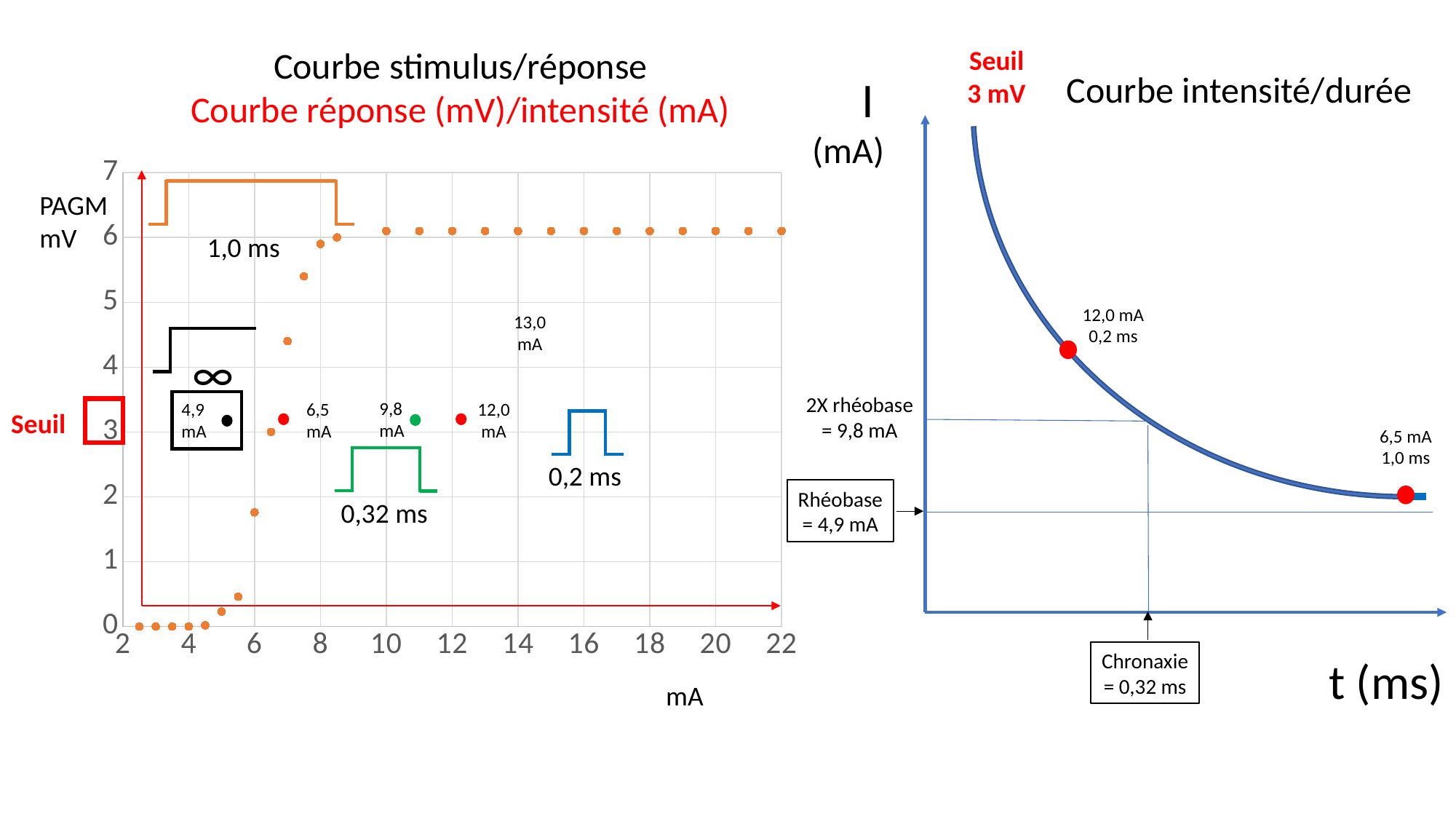
On the left chart 'Courbe stimulus/réponse', do the orange points rise or fall as intensity increases from 4 mA to 10 mA? rise On the right chart 'Courbe intensité/durée', what is the value of the Rhéobase? 4,9 mA What kind of chart is the left chart, 'Courbe stimulus/réponse'? scatter plot On the right chart 'Courbe intensité/durée', does the curve rise or fall as t increases? fall On the right chart 'Courbe intensité/durée', what is the difference between the intensity at 0,2 ms and the intensity at 1,0 ms? 5,5 mA On the right chart 'Courbe intensité/durée', what intensity is marked at a duration of 0,2 ms? 12,0 mA On the left chart 'Courbe stimulus/réponse', what pulse duration is labelled next to the orange pulse shape? 1,0 ms On the left chart 'Courbe stimulus/réponse', is the response value at 20 mA greater or less than 5 mV? greater On the left chart 'Courbe stimulus/réponse', what is the threshold (Seuil) value marked on the y axis? 3 mV On the right chart 'Courbe intensité/durée', what is the value labelled '2X rhéobase'? 9,8 mA On the left chart 'Courbe stimulus/réponse', is the response value at 3 mA greater or less than 1 mV? less On the right chart 'Courbe intensité/durée', what is the value of the Chronaxie? 0,32 ms